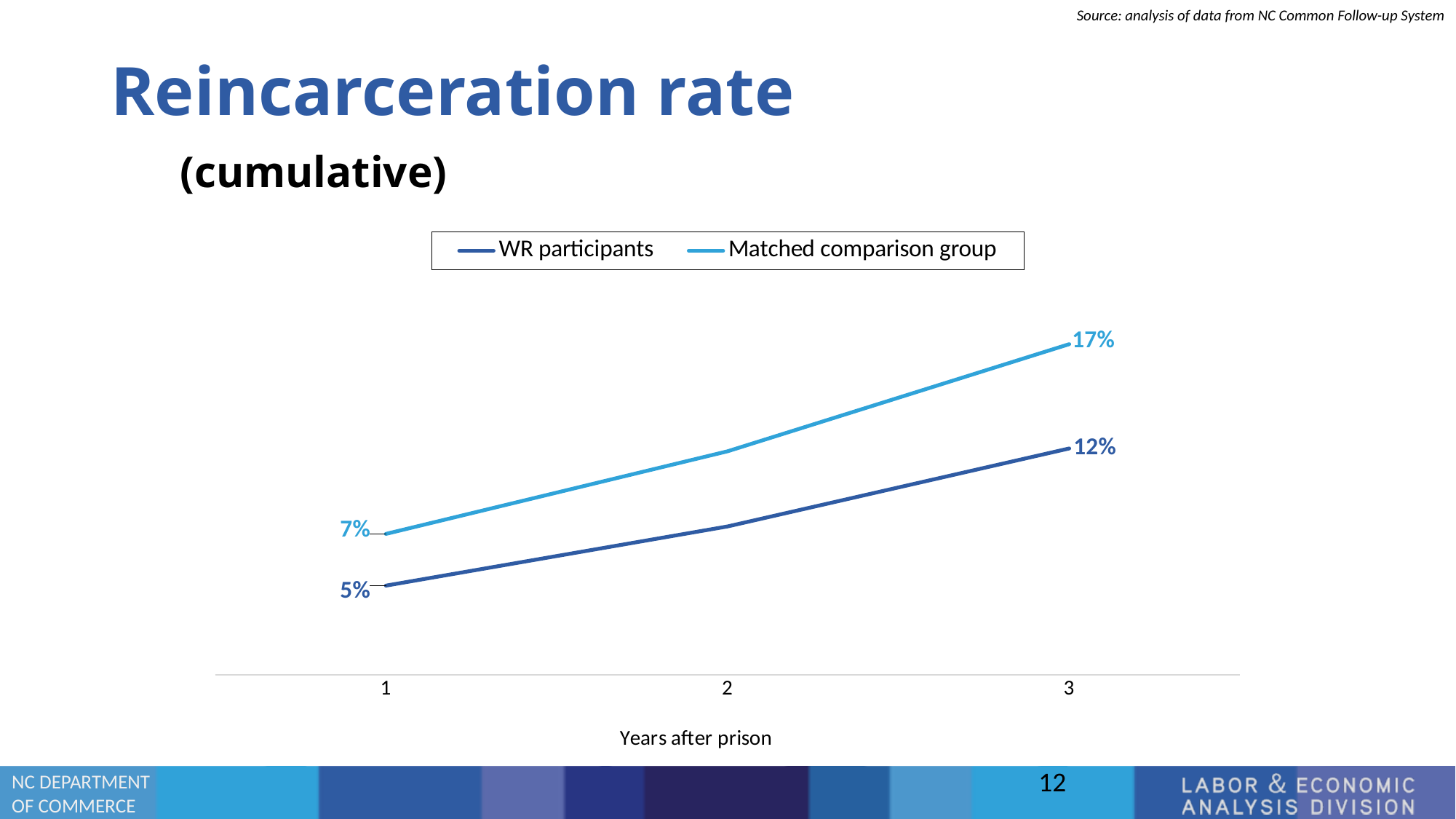
What is the reincarceration rate for WR participants at year 1? 5% What is the reincarceration rate for the Matched comparison group at year 1? 7% Do the reincarceration rates rise or fall as years after prison increase? Rise Which group has the lower reincarceration rate at year 1? WR participants What is the reincarceration rate for the Matched comparison group at year 3? 17% How many series does the legend list? 2 What is the reincarceration rate for WR participants at year 3? 12% Which group has the higher reincarceration rate at year 3? Matched comparison group By how much did the WR participants' rate increase from year 1 to year 3? 7% What kind of chart is shown? Line chart How many points on the x axis (years after prison) are shown? 3 What is the difference between the Matched comparison group and WR participants at year 3? 5%